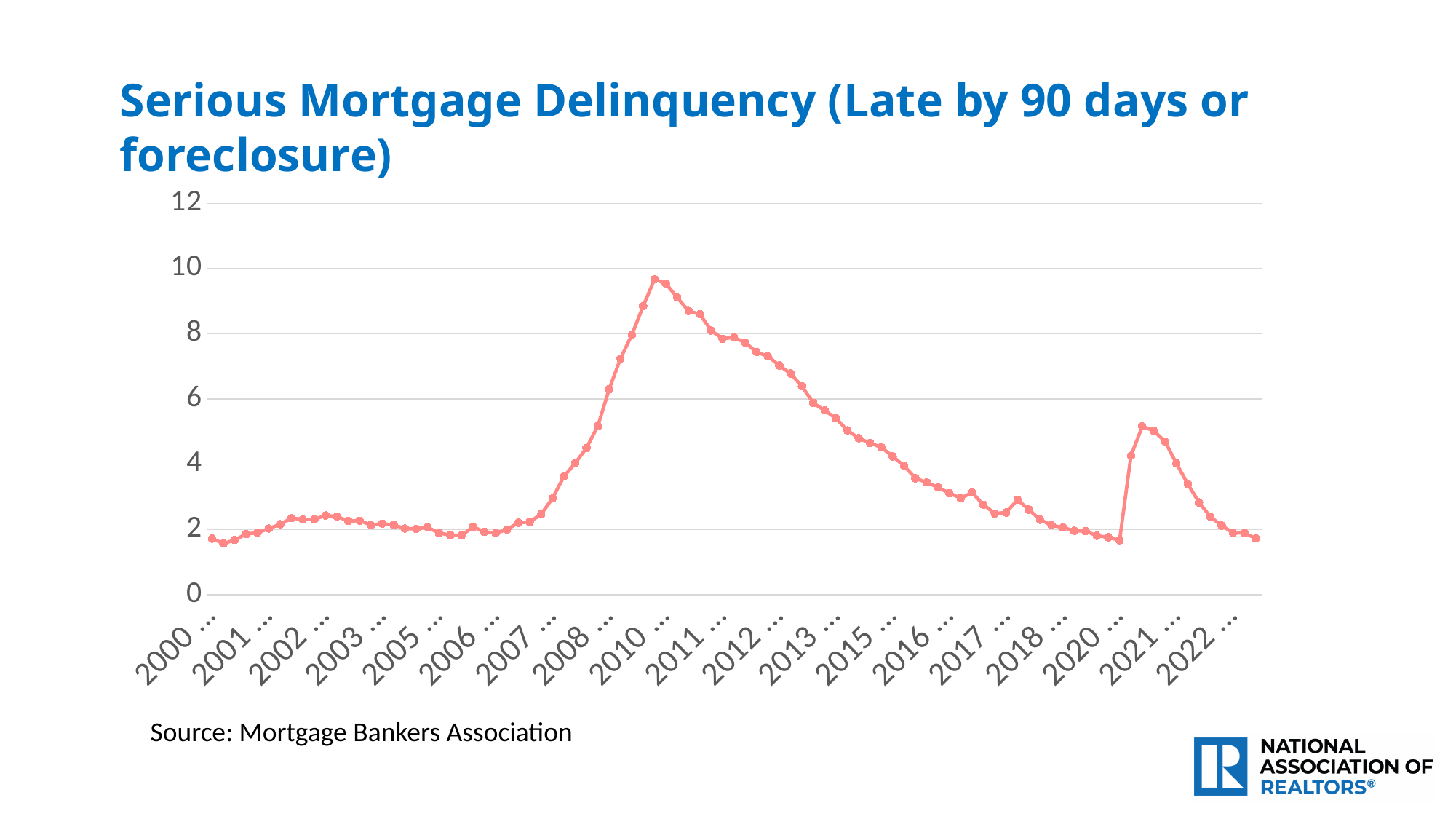
Is the value at the 2021 peak greater or less than 6? less Does the line rise or fall between the 2010 peak and 2018? fall Which is larger, the peak around 2010 or the peak around 2021? the peak around 2010 What kind of chart is shown on the slide? line chart Is the value at the 2013 label greater or less than 4? greater Is the peak value of the line around 2010 greater or less than 10? less What is the title of the chart? Serious Mortgage Delinquency (Late by 90 days or foreclosure) Around which year label does the line reach its highest value? 2010 What source is cited for the chart's data? Mortgage Bankers Association